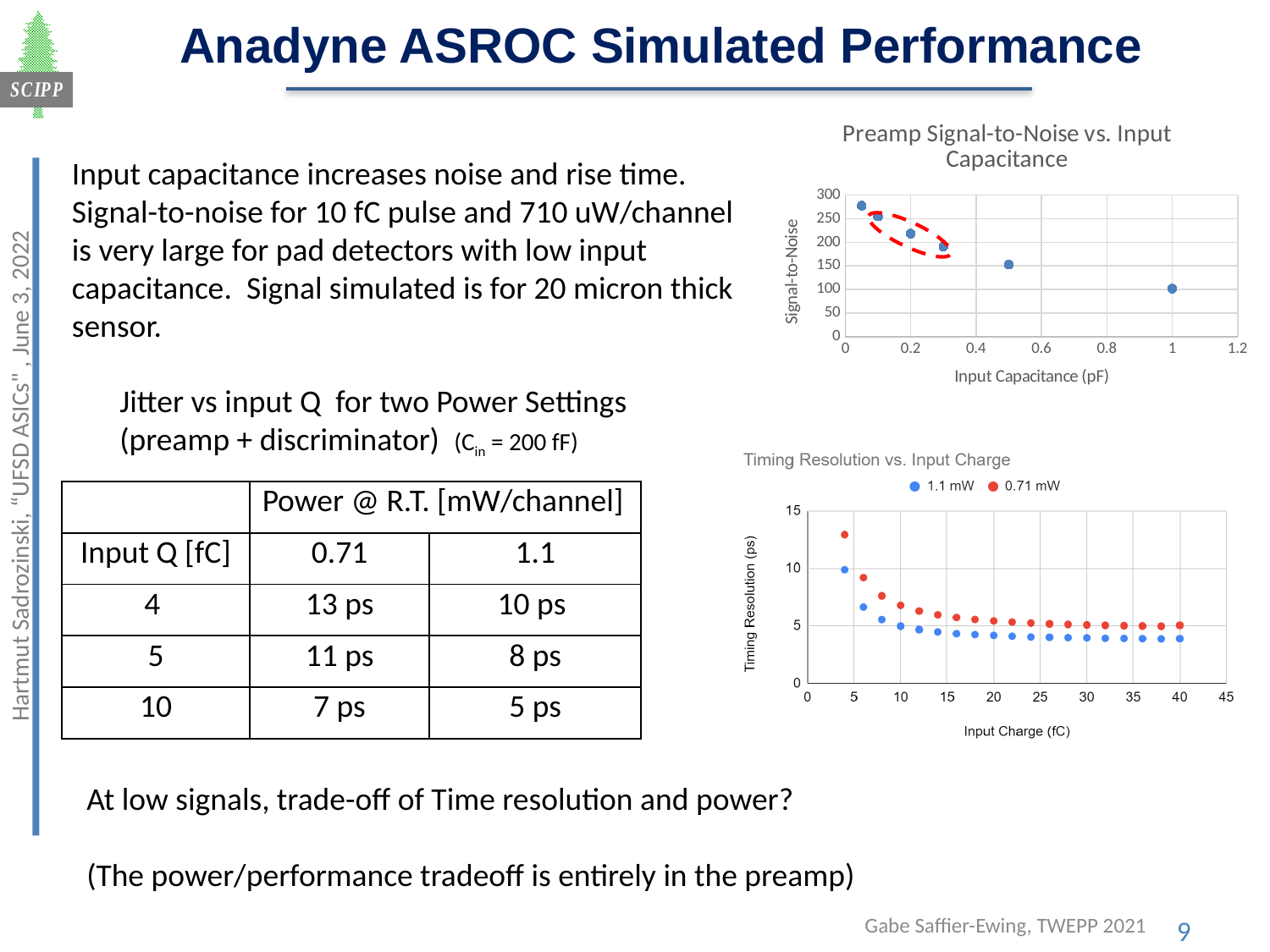
In the 'Timing Resolution vs. Input Charge' chart, is the 0.71 mW timing resolution at 4 fC greater or less than 10 ps? greater In the 'Timing Resolution vs. Input Charge' chart, does timing resolution rise or fall as input charge increases? fall What is the x-axis label of the 'Preamp Signal-to-Noise vs. Input Capacitance' chart? Input Capacitance (pF) In the 'Preamp Signal-to-Noise vs. Input Capacitance' chart, which plotted capacitance has the lowest signal-to-noise? 1 pF In the 'Preamp Signal-to-Noise vs. Input Capacitance' chart, does signal-to-noise rise or fall as input capacitance increases? fall How many series does the legend of the 'Timing Resolution vs. Input Charge' chart list? 2 In the 'Preamp Signal-to-Noise vs. Input Capacitance' chart, is the signal-to-noise at the lowest plotted capacitance greater or less than 250? greater What are the two series named in the legend of the 'Timing Resolution vs. Input Charge' chart? 1.1 mW and 0.71 mW In the 'Preamp Signal-to-Noise vs. Input Capacitance' chart, is the signal-to-noise at 0.5 pF greater or less than 200? less What type of chart is the 'Preamp Signal-to-Noise vs. Input Capacitance' chart? scatter chart In the 'Timing Resolution vs. Input Charge' chart, which series has the higher timing resolution at 4 fC, 1.1 mW or 0.71 mW? 0.71 mW How many data points are plotted in the 'Preamp Signal-to-Noise vs. Input Capacitance' chart? 6